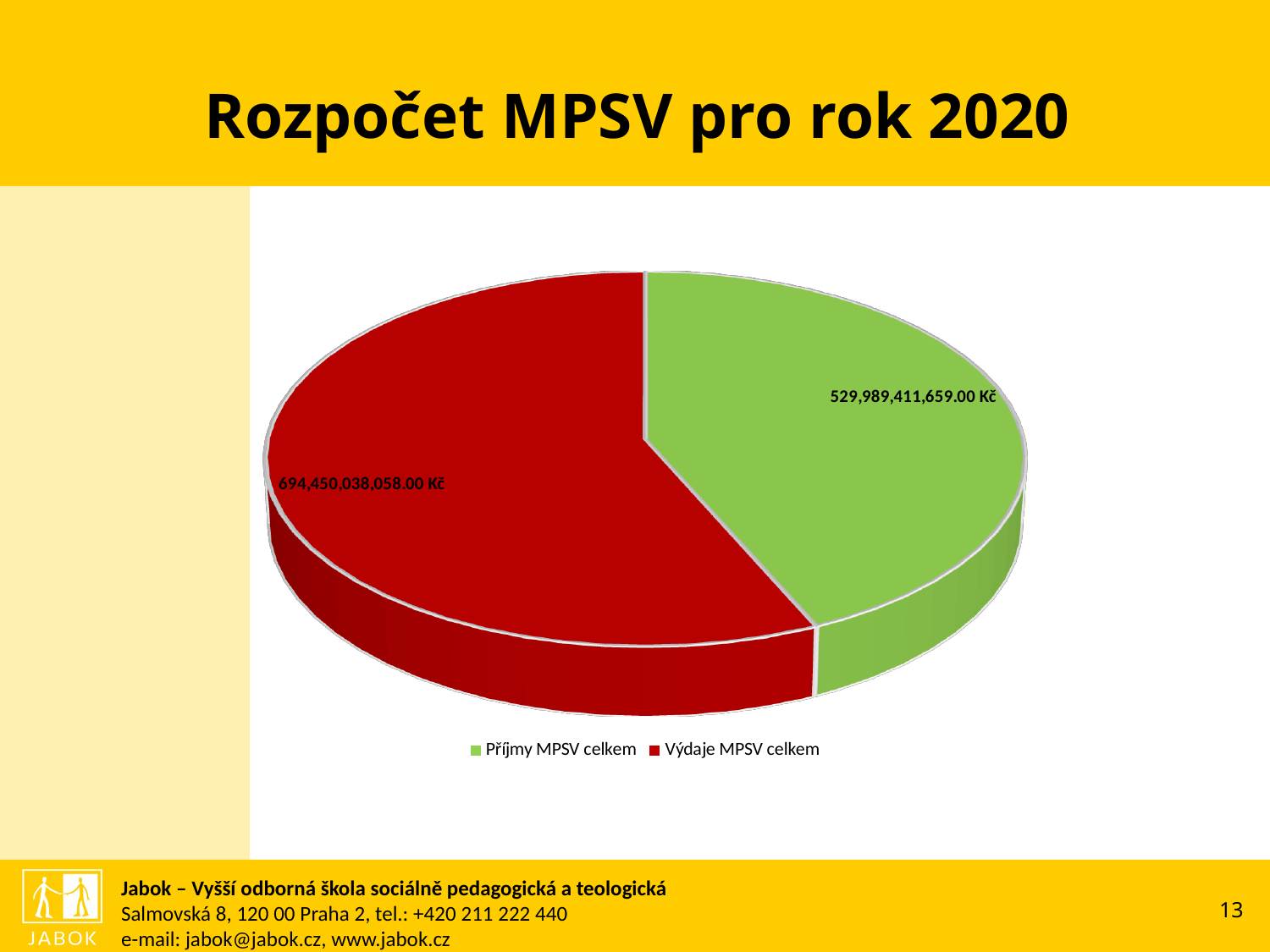
Which slice of the pie is the largest? Výdaje MPSV celkem What colour is the Výdaje MPSV celkem slice? Red What share of the pie does Výdaje MPSV celkem represent, to one decimal place? 56.7% What is the total of the two slices in the pie chart? 1,224,439,449,717.00 Kč What kind of chart is shown on the slide? Pie chart By how much does Výdaje MPSV celkem exceed Příjmy MPSV celkem? 164,460,626,399.00 Kč Which is larger, Příjmy MPSV celkem or Výdaje MPSV celkem? Výdaje MPSV celkem How many slices does the pie chart have? 2 How many entries does the legend list? 2 What is the value of the Výdaje MPSV celkem slice? 694,450,038,058.00 Kč What is the value of the Příjmy MPSV celkem slice? 529,989,411,659.00 Kč Which slice of the pie is the smallest? Příjmy MPSV celkem